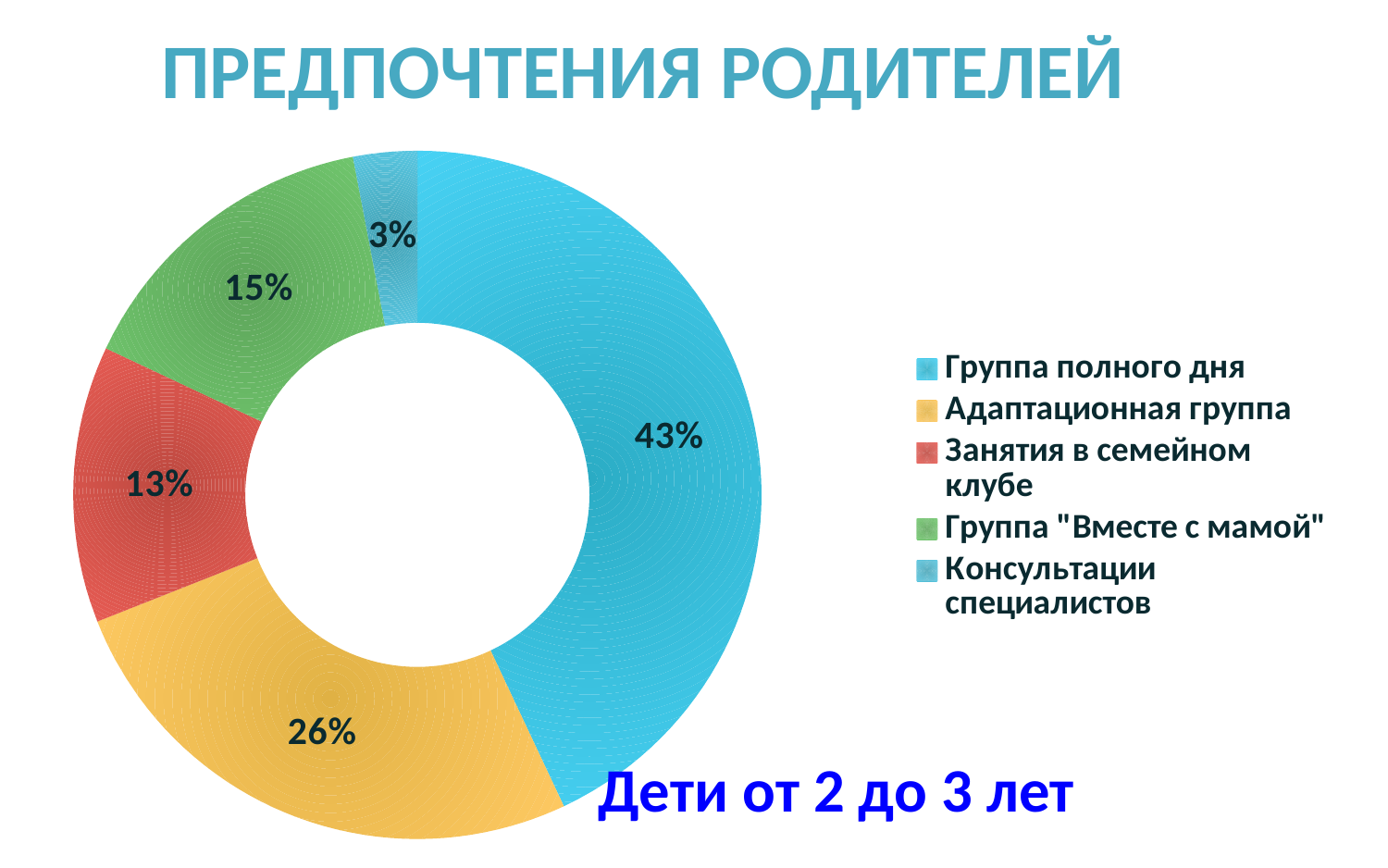
Which category has the smallest share? Консультации специалистов What share of the pie does Группа полного дня have? 43% What kind of chart is shown on the slide? Pie chart (doughnut) What is the value for Консультации специалистов? 3% What is the title of the slide? ПРЕДПОЧТЕНИЯ РОДИТЕЛЕЙ How many categories does the chart show? 5 Which is larger: Группа "Вместе с мамой" or Занятия в семейном клубе? Группа "Вместе с мамой" Which category has the largest share? Группа полного дня What is the difference between the shares of Группа полного дня and Адаптационная группа? 17% What is the value for Адаптационная группа? 26% What is the value for Занятия в семейном клубе? 13% What is the value for Группа "Вместе с мамой"? 15%